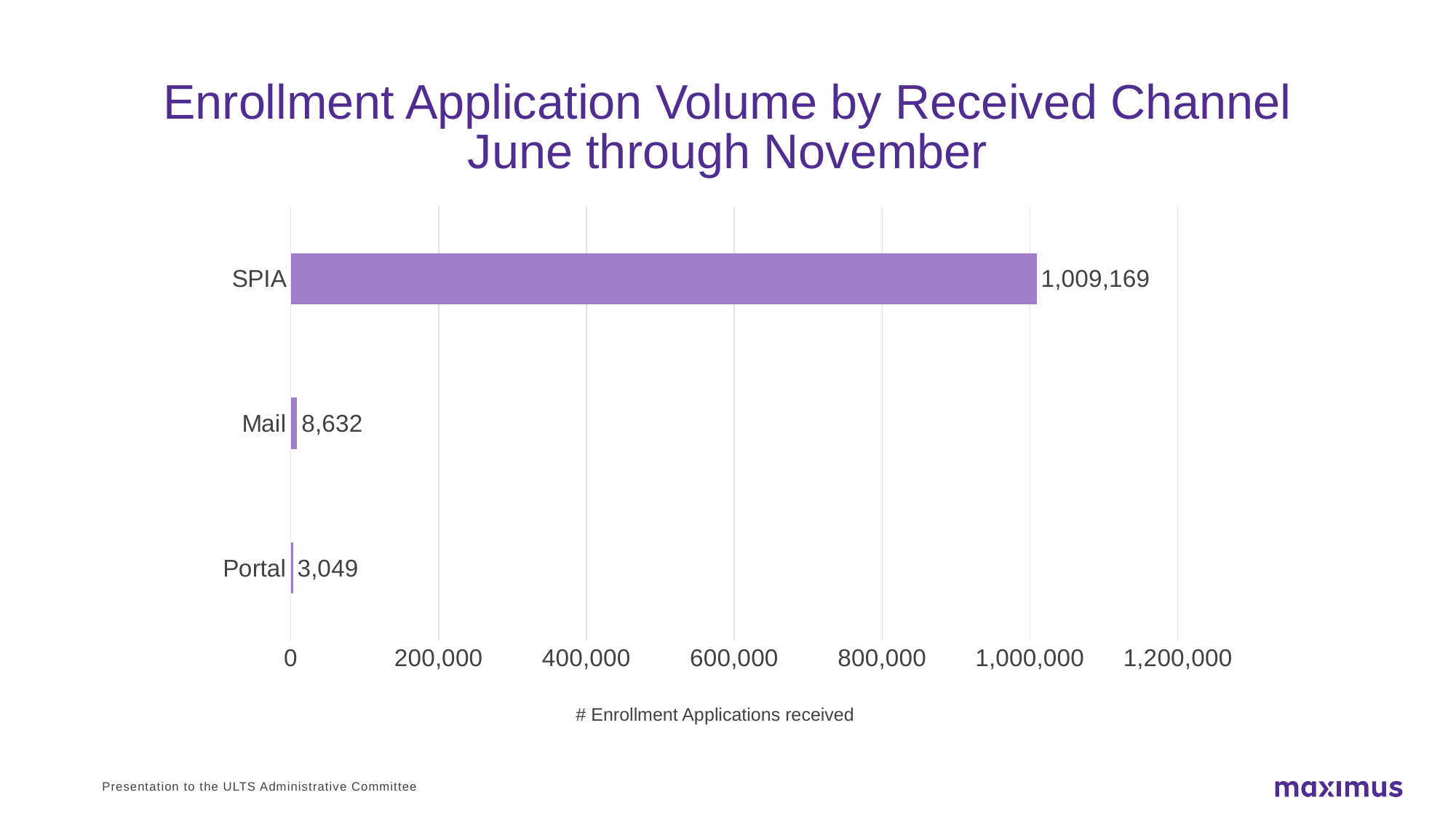
What is the label of the horizontal axis? # Enrollment Applications received How many channels are shown in the chart? 3 Is the value for SPIA greater or less than 1,000,000? greater What is the difference between the number of applications received via Mail and via Portal? 5,583 What is the number of enrollment applications received via Portal? 3,049 What kind of chart is shown on the slide? Bar chart What is the difference between the number of applications received via SPIA and via Mail? 1,000,537 Which channel received more applications, Mail or Portal? Mail Which channel received the lowest number of enrollment applications? Portal What is the number of enrollment applications received via Mail? 8,632 Which channel received the highest number of enrollment applications? SPIA What is the number of enrollment applications received via SPIA? 1,009,169